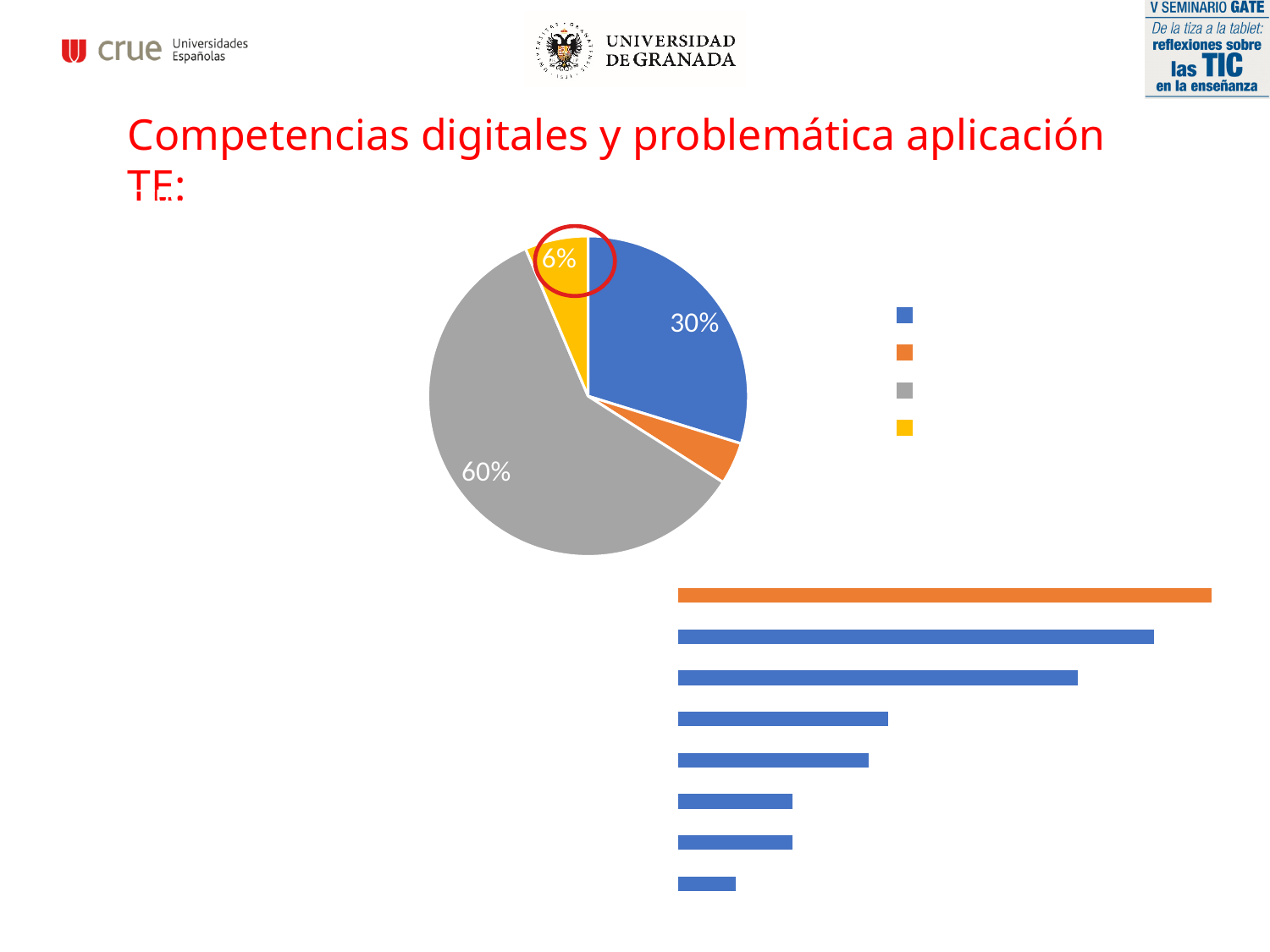
How many slices does the pie chart have? 4 In the pie chart, which is larger, the blue slice or the yellow slice? the blue slice In the pie chart, which slice is the largest? the grey slice (60%) What kind of chart is the upper chart on the slide? pie chart What kind of chart is the lower chart on the slide? bar chart In the pie chart, what percentage is shown for the blue slice? 30% In the pie chart, what percentage is shown for the grey slice? 60% How many bars does the lower bar chart have? 8 In the pie chart, which slice is the smallest? the orange slice How many entries does the legend of the pie chart list? 4 In the pie chart, what percentage is shown for the yellow slice? 6% In the pie chart, how many percentage points larger is the grey slice than the blue slice? 30